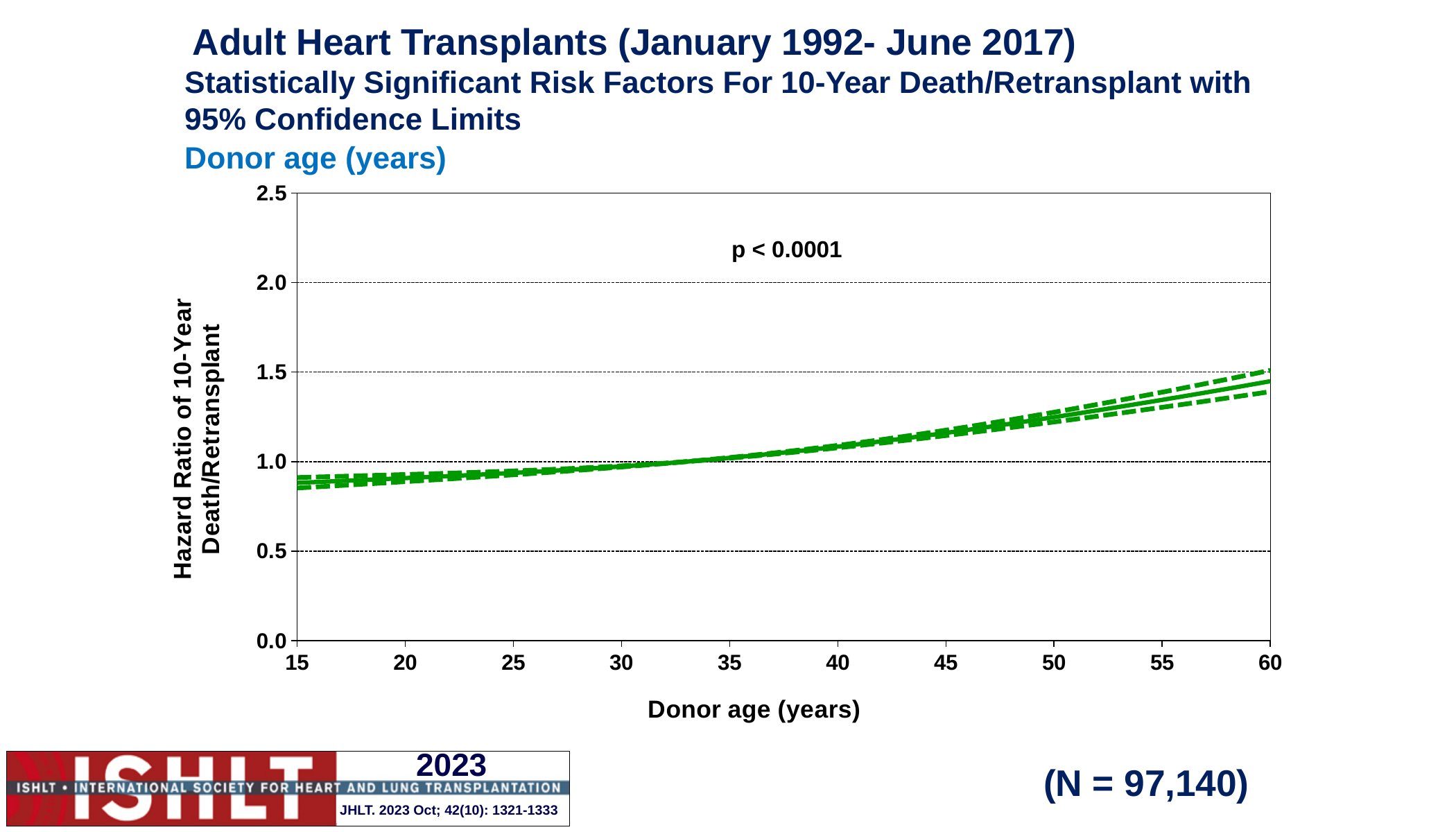
What is the label of the y axis of the chart? Hazard Ratio of 10-Year Death/Retransplant How many tick labels are shown on the x axis of the chart? 10 Which donor age has the higher hazard ratio, 20 years or 55 years? 55 years Is the hazard ratio at a donor age of 60 years greater or less than 1.0? greater What kind of chart is shown on the slide? line chart Is the hazard ratio at a donor age of 50 years greater or less than 1.0? greater Is the hazard ratio at a donor age of 20 years greater or less than 1.0? less Does the hazard ratio rise or fall as donor age increases from 15 to 60 years? rise What p-value is printed on the chart? p < 0.0001